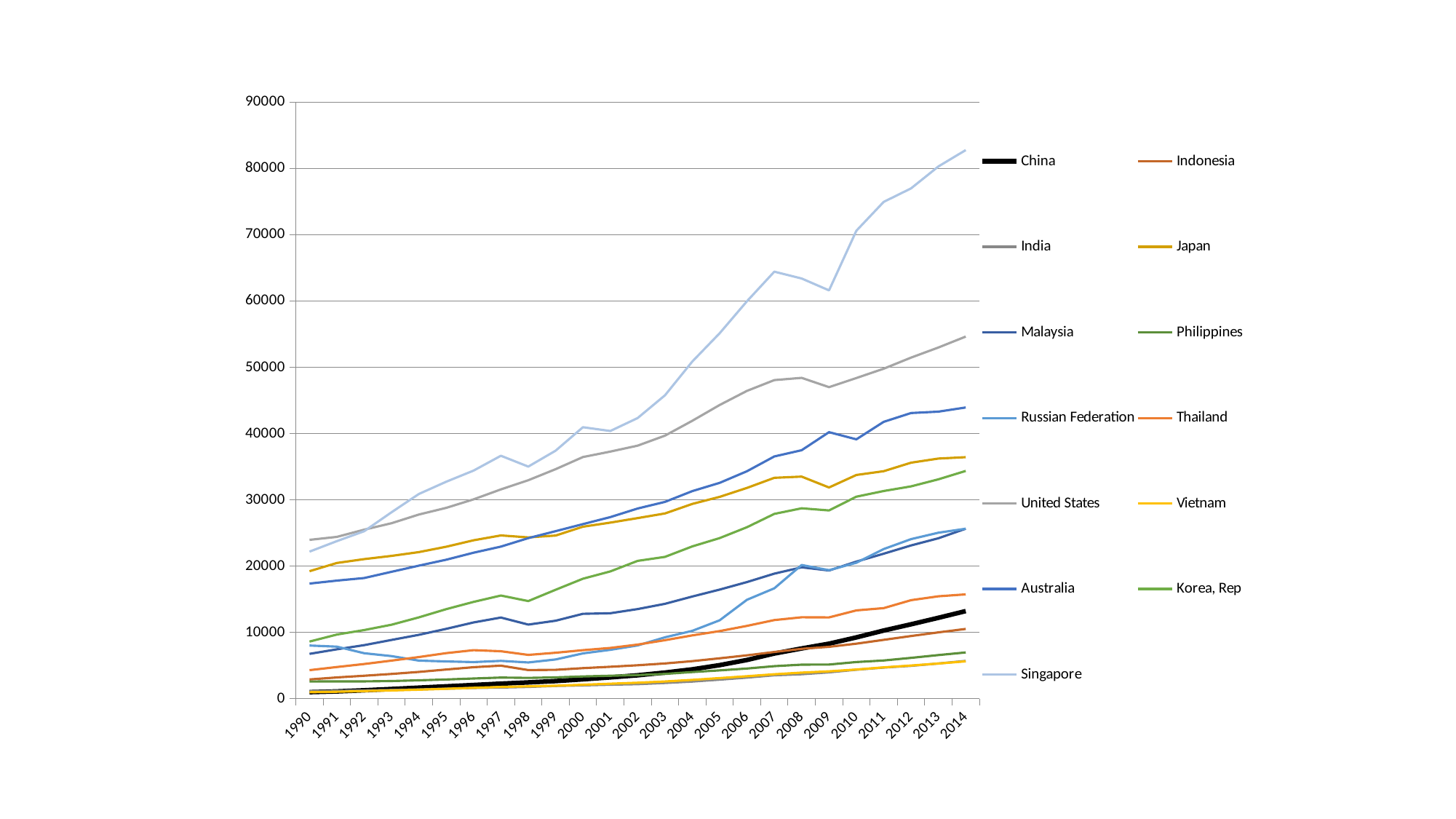
Is the value for United States in 2014 greater or less than 50000? greater Which series has the highest value in 2014? Singapore Does the value for China rise or fall from 1990 to 2014? rise How many years are shown along the x axis? 25 Is the value for China in 2014 greater or less than 10000? greater Is the value for Singapore in 2014 greater or less than 80000? greater Which is larger in 2014, the value for Australia or the value for Japan? Australia Which series is drawn with the thick black line? China What kind of chart is shown on the slide? line chart How many series does the legend list? 13